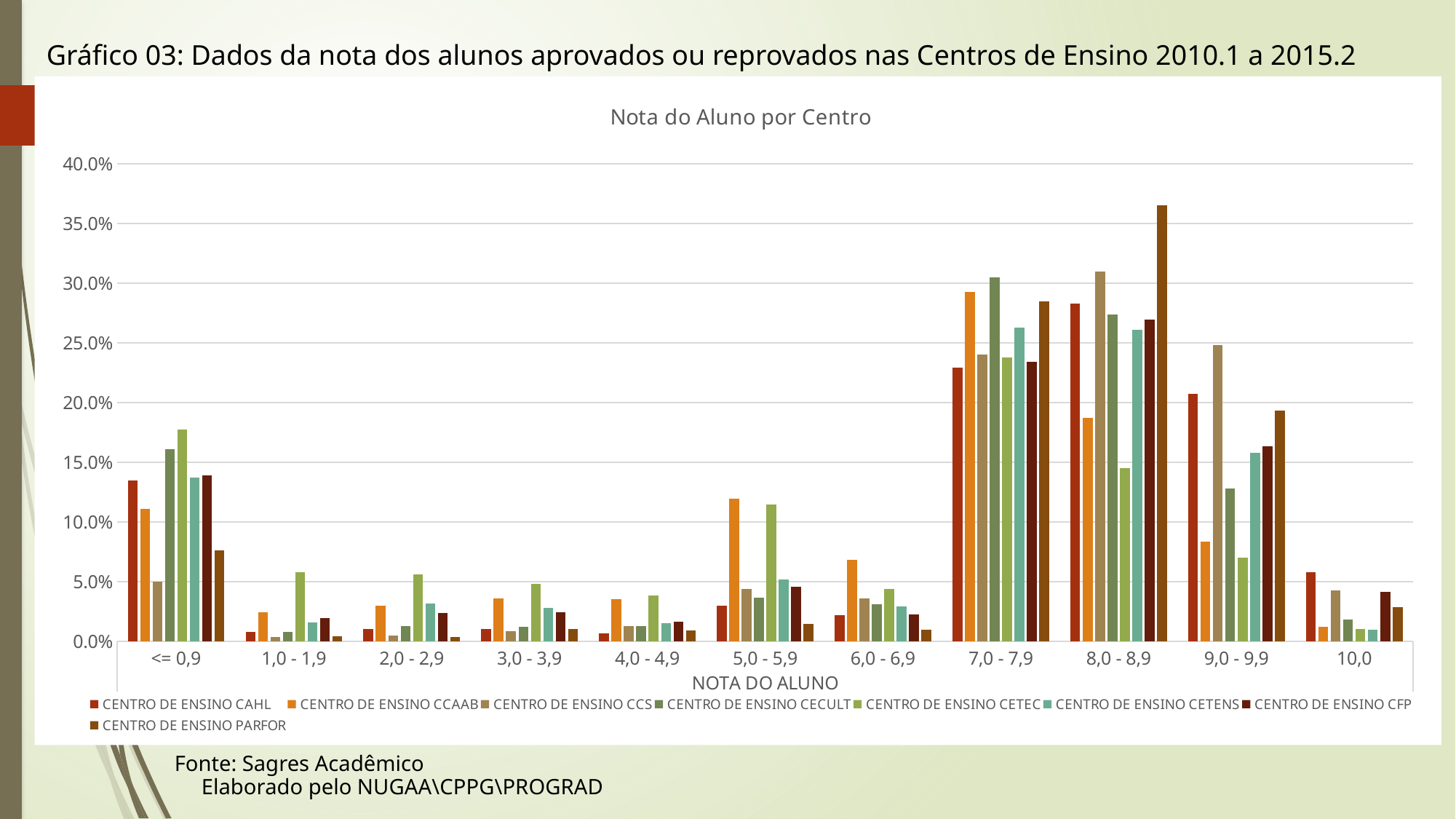
Is the value for CENTRO DE ENSINO CETEC in the 8,0 - 8,9 category greater or less than 20.0%? less How many series does the legend list? 8 Which centre has the tallest bar in the whole chart? CENTRO DE ENSINO PARFOR In the 8,0 - 8,9 category, which centre has the lowest value? CENTRO DE ENSINO CETEC Is the value for CENTRO DE ENSINO CETEC in the <= 0,9 category greater or less than 15.0%? greater Is the value for CENTRO DE ENSINO PARFOR in the 8,0 - 8,9 category greater or less than 35.0%? greater How many score categories are shown on the x axis? 11 What is the label of the x axis? NOTA DO ALUNO In the 9,0 - 9,9 category, which centre has the highest value? CENTRO DE ENSINO CCS What is the title of the chart? Nota do Aluno por Centro What kind of chart is shown on the slide? bar chart